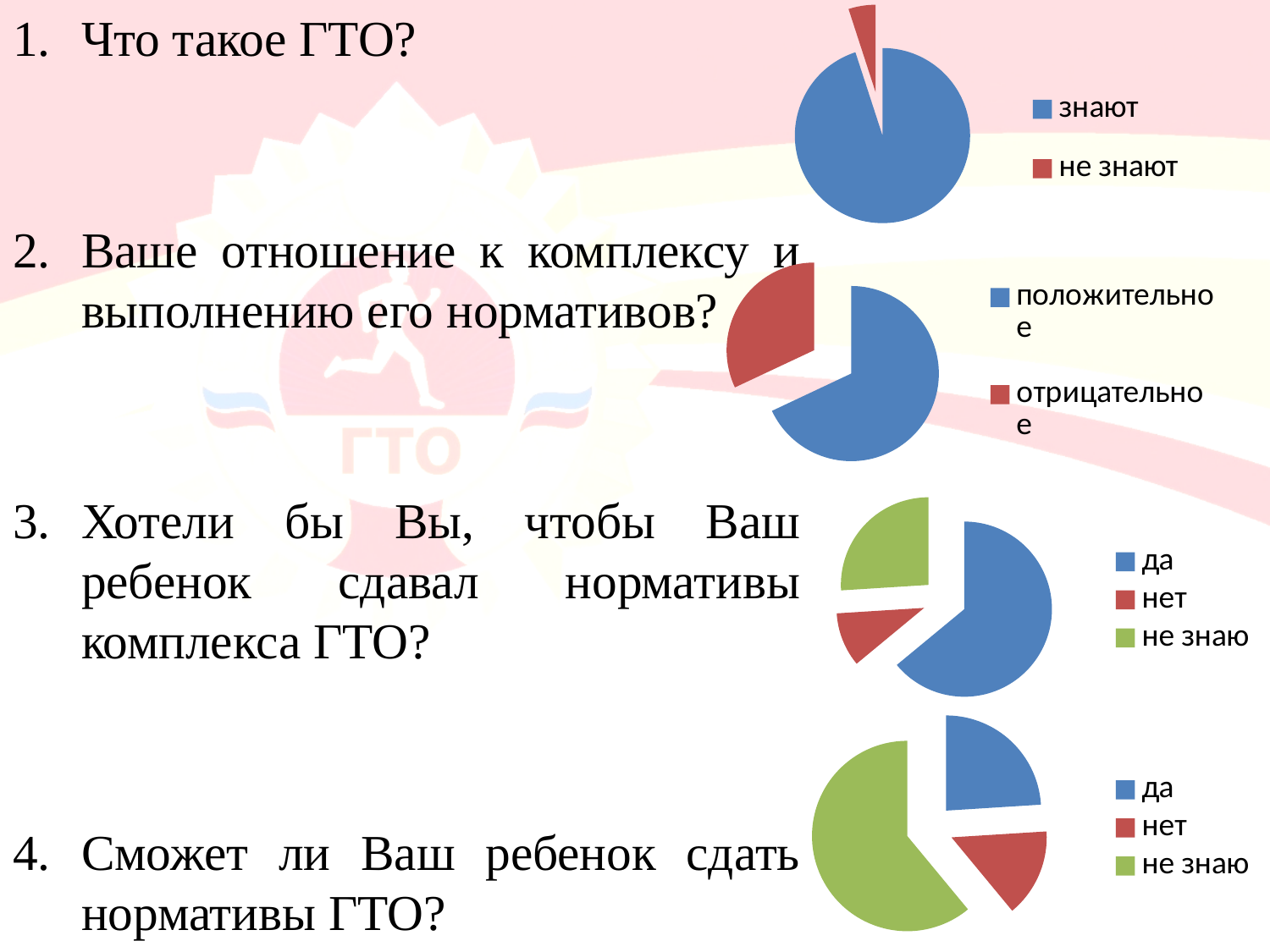
What colour represents 'не знаю' in the bottom pie chart (question 4)? green How many slices does the third pie chart from the top (question 3) have? 3 In the third pie chart (question 3), which category has the smallest slice? нет How many entries does the legend of the second pie chart (question 2) list? 2 In the bottom pie chart (question 4), which slice is larger: 'да' or 'не знаю'? не знаю In the third pie chart (question 3), which category has the largest slice? да In the top pie chart (question 1), which category has the largest slice? знают What kind of chart is the top chart on the slide (next to question 1, 'Что такое ГТО?')? pie chart How many entries does the legend of the top pie chart (question 1) list? 2 In the top pie chart (question 1), which category has the smallest slice? не знают In the second pie chart from the top (question 2), which slice is larger: 'положительное' or 'отрицательное'? положительное In the bottom pie chart (question 4), which category has the largest slice? не знаю